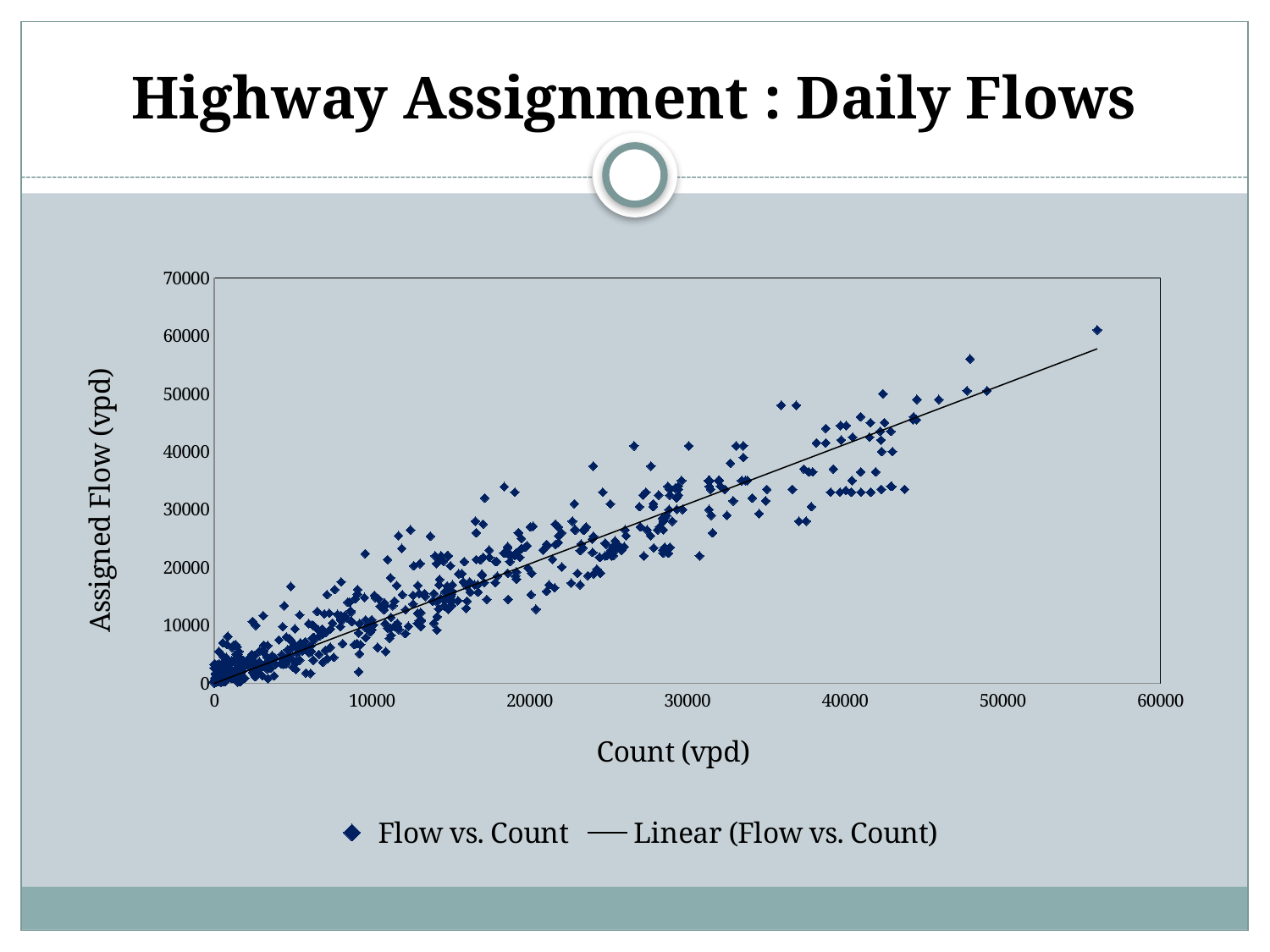
Is the assigned flow of the point with the highest count greater or less than 40000? greater Do the assigned flow values generally rise or fall as the count increases along the x axis? rise Is the assigned flow of the point with the highest count greater or less than 50000? greater How many entries does the legend list? 2 What is the highest value shown on the x axis? 60000 What is the highest value shown on the y axis? 70000 What is the title of the y axis? Assigned Flow (vpd) What is the title of the x axis? Count (vpd) Is the count of the point with the highest assigned flow greater or less than 50000? greater What kind of chart is shown on the slide? scatter chart